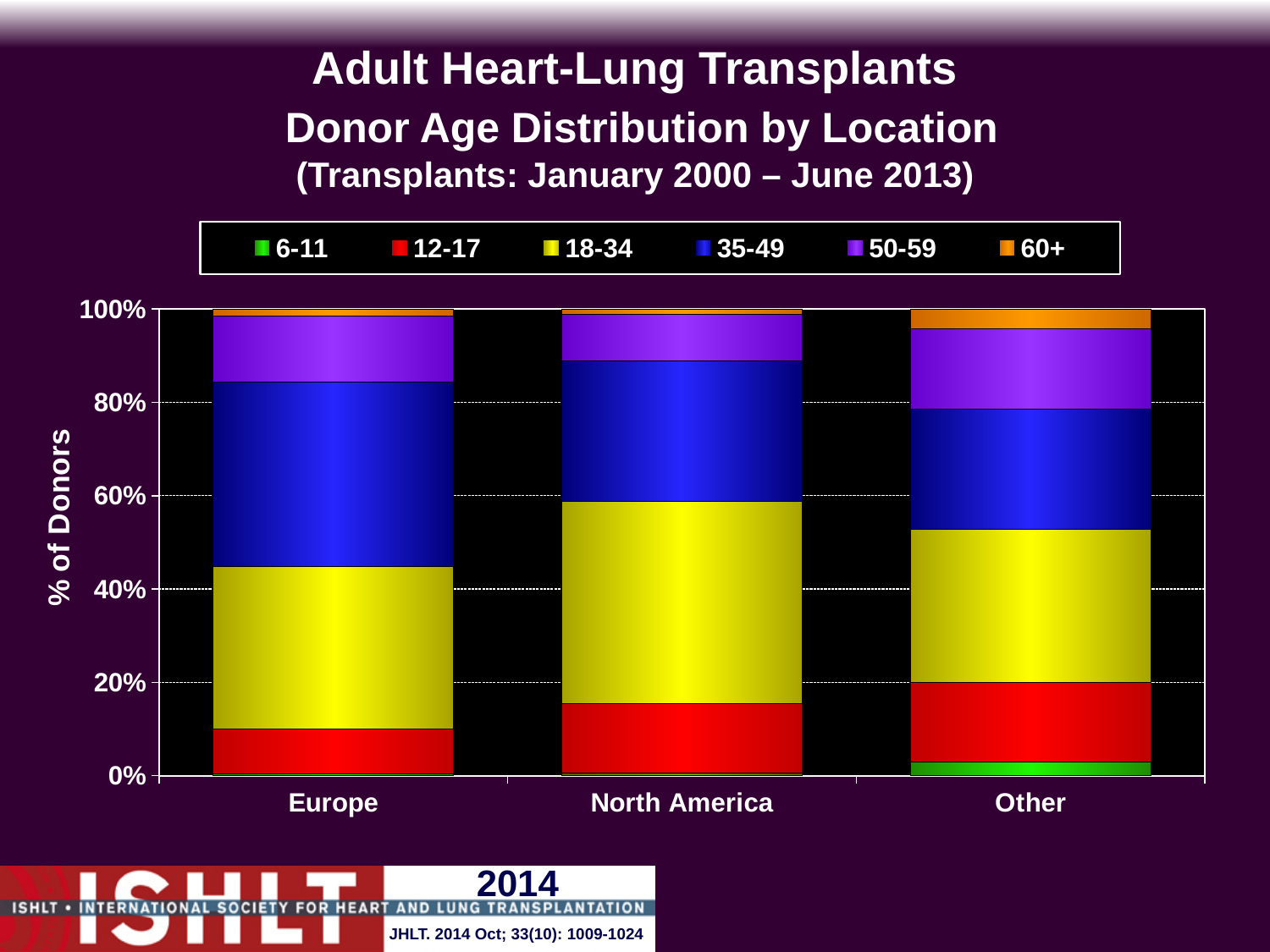
Is the 12-17 share of donors for Europe greater or less than 20%? less How many locations are shown along the x axis? 3 Is the 6-11 share of donors for Other greater or less than 20%? less Which has a larger 12-17 share of donors, Europe or Other? Other What is the label of the y axis? % of Donors Which age group is shown in yellow in the legend? 18-34 Which location has the largest 18-34 share of donors? North America Which location has the largest 35-49 share of donors? Europe What kind of chart is shown on the slide? Stacked bar chart Is the 18-34 share of donors for North America greater or less than 20%? greater Which location is the only one with a visible 6-11 segment? Other How many donor age groups does the legend list? 6